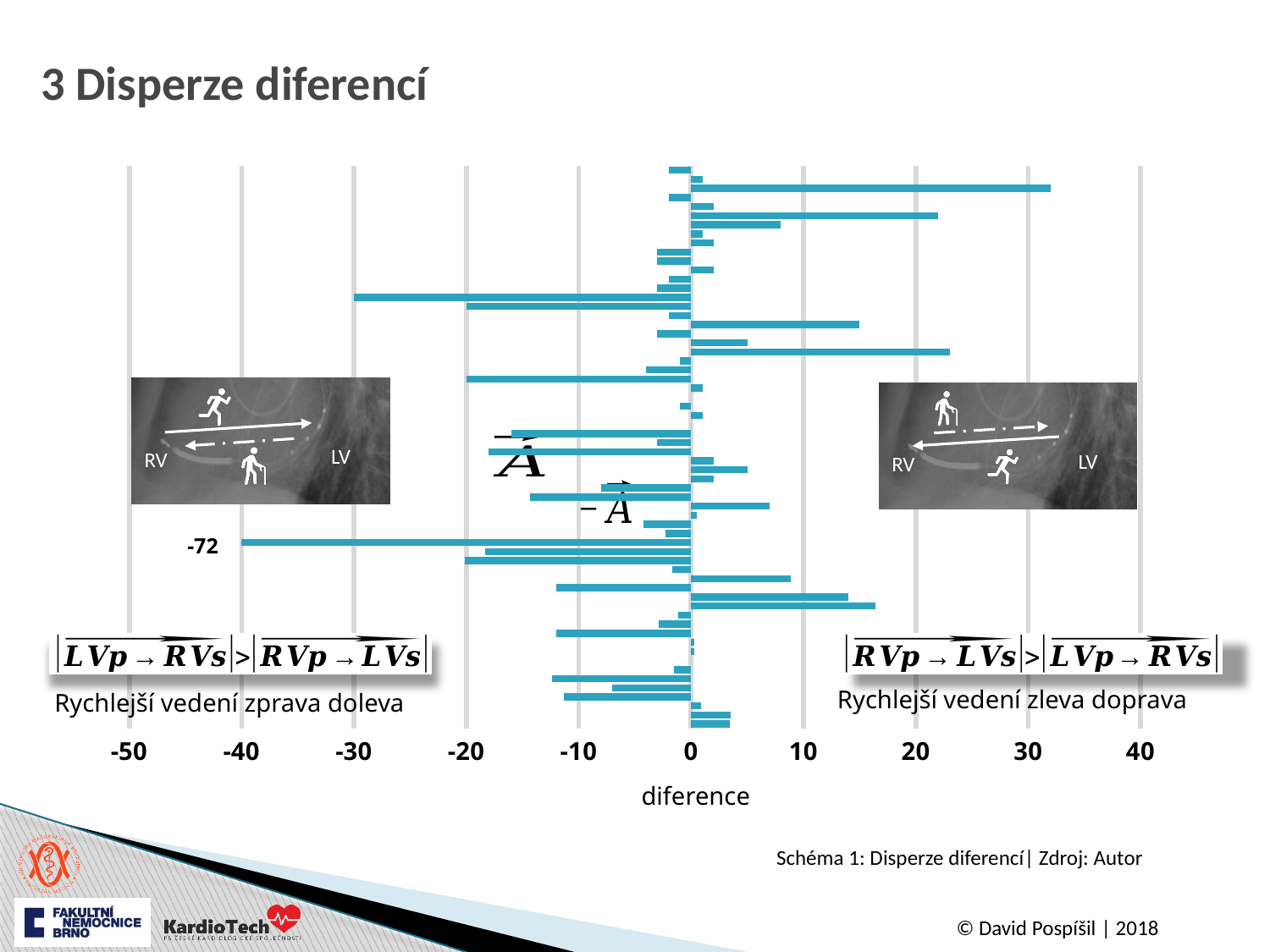
What is the rightmost tick label on the horizontal axis? 40 What is the lowest value printed as a data label on the chart? -72 What is the leftmost tick label on the horizontal axis? -50 Is the longest bar extending to the right greater or less than 40? less Is the longest bar extending to the right greater or less than 30? greater What is the caption given for the chart below it? Schéma 1: Disperze diferencí| Zdroj: Autor Are the bars in the chart drawn horizontally or vertically? horizontally What is the title of the horizontal axis of the chart? diference Which is larger in absolute size: the bar labelled -72 or the longest bar extending to the right? the bar labelled -72 What kind of chart is shown on the slide? bar chart